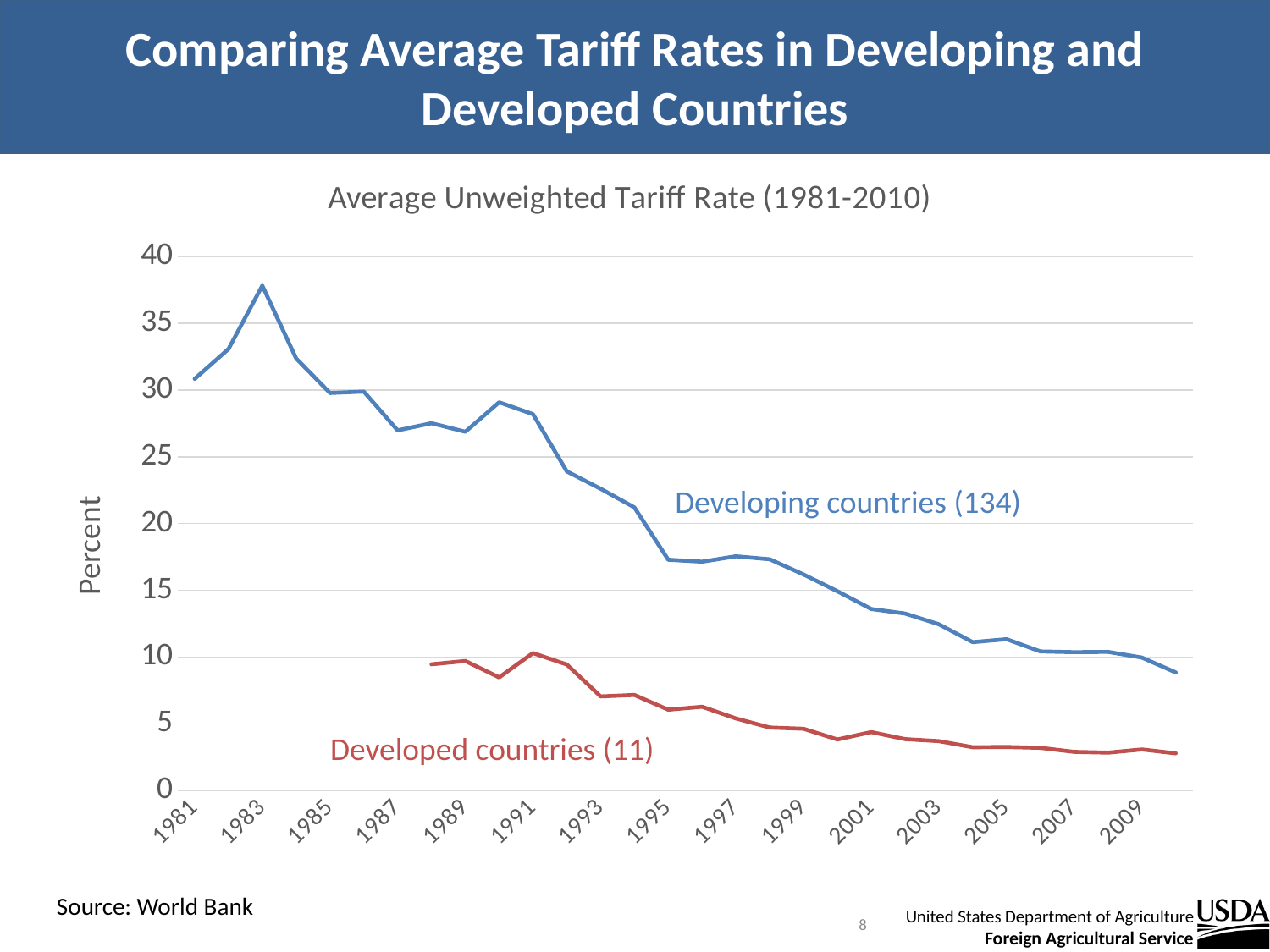
In which year does the Developing countries series reach its highest value? 1983 What is the label on the vertical axis? Percent Which series has the higher value in 1995, Developing countries or Developed countries? Developing countries What is the title of the chart? Average Unweighted Tariff Rate (1981-2010) What kind of chart is shown on the slide? Line chart Does the Developing countries series generally rise or fall from 1983 to 2010? Fall Is the value for Developing countries in 1981 greater or less than 30? greater Is the value for Developed countries in 2009 greater or less than 5? less Is the value for Developing countries in 1995 greater or less than 20? less How many series are plotted on the chart? 2